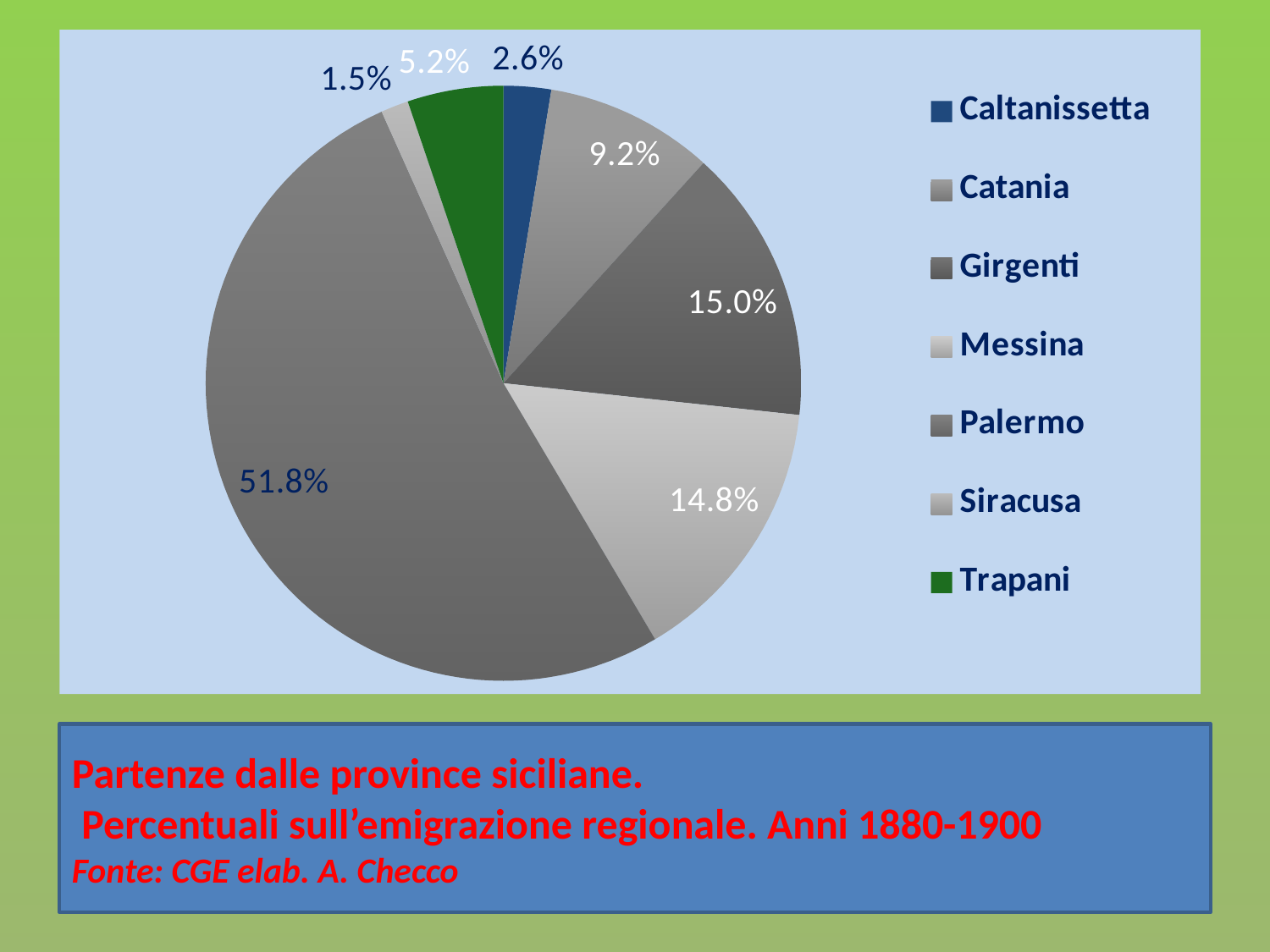
Which province is represented by the green slice? Trapani What percentage of the pie does Palermo account for? 51.8% How many provinces are listed in the legend? 7 What is the value shown for Girgenti? 15.0% What kind of chart is shown on the slide? Pie chart What is the difference between the shares of Palermo and Messina? 37.0% Which province has the largest share of the pie? Palermo What is the value for Trapani? 5.2% Which province has the smallest share of the pie? Siracusa What is the combined share of Caltanissetta and Siracusa? 4.1% Which is larger, the share for Catania or the share for Trapani? Catania What percentage is shown for Catania? 9.2%